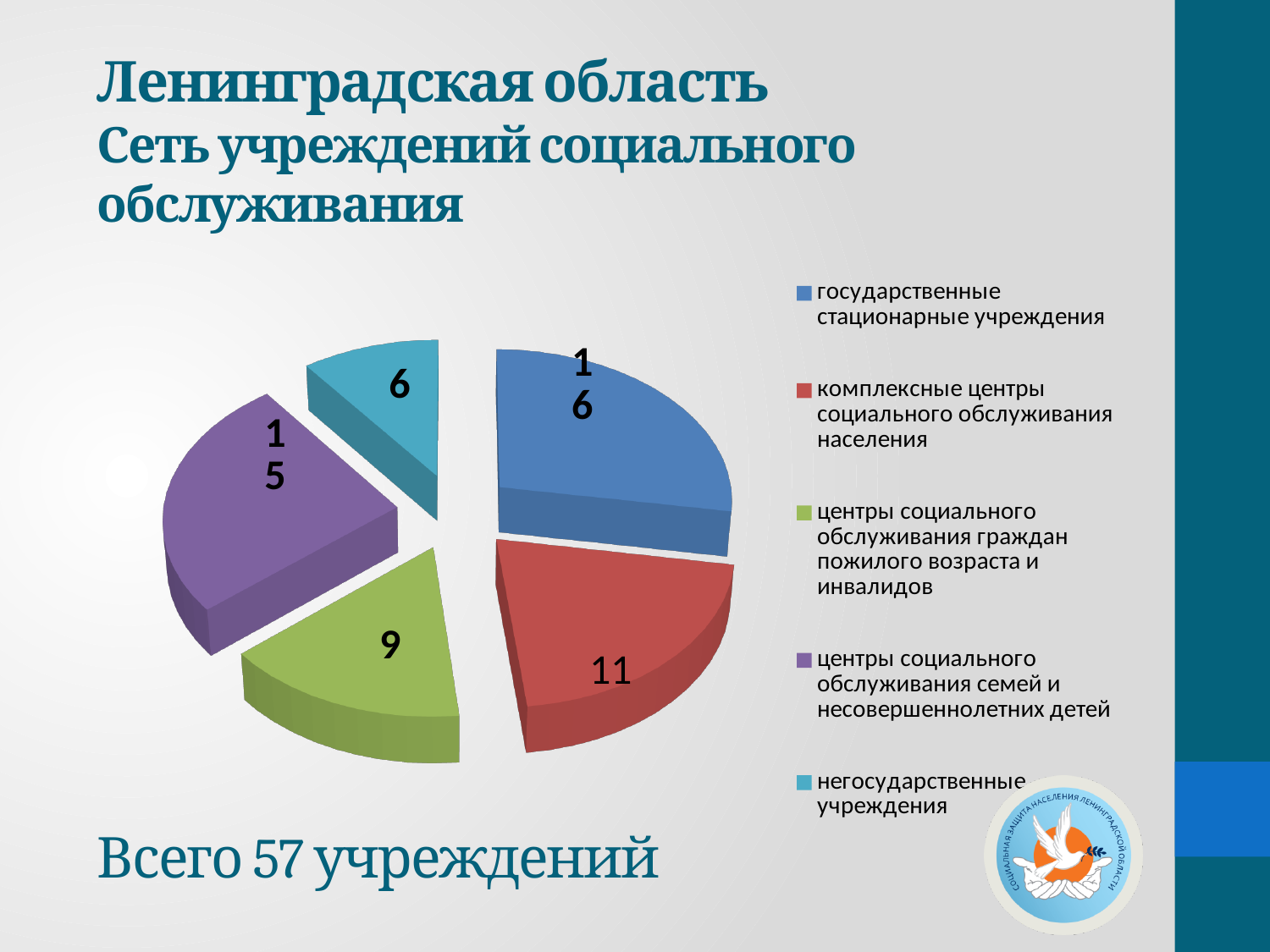
What is the value for государственные стационарные учреждения? 16 What is the value for комплексные центры социального обслуживания населения? 11 Which category has the largest slice of the pie? государственные стационарные учреждения What is the value for негосударственные учреждения? 6 How many entries does the legend of the pie chart list? 5 What is the value for центры социального обслуживания семей и несовершеннолетних детей? 15 What is the difference between the values for государственные стационарные учреждения and негосударственные учреждения? 10 What kind of chart is shown on the slide? pie chart What is the value for центры социального обслуживания граждан пожилого возраста и инвалидов? 9 How many slices does the pie chart have? 5 What is the total number of institutions stated on the slide? 57 Which category has the smallest slice of the pie? негосударственные учреждения